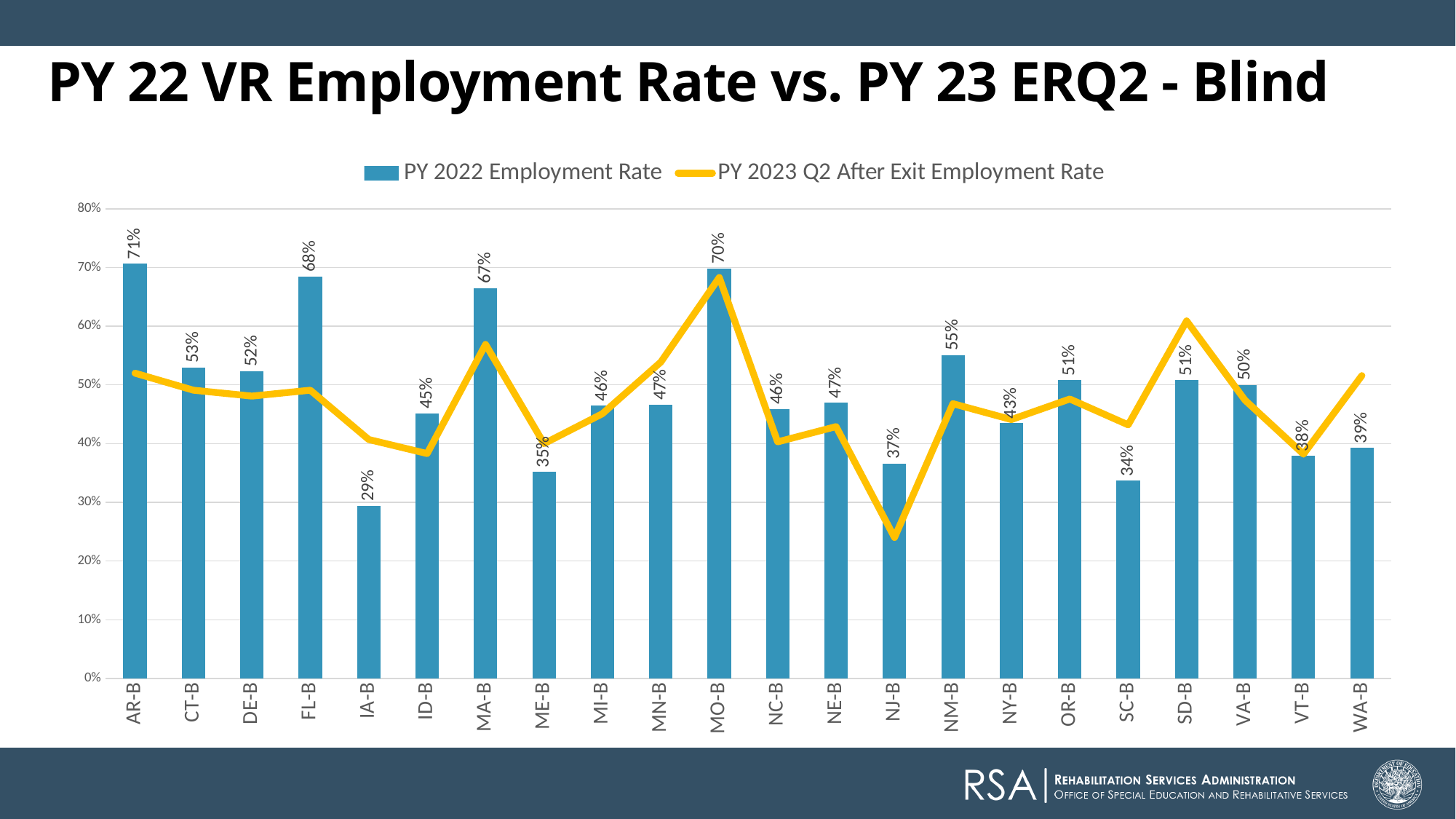
How many categories are shown on the x axis? 22 Is the PY 2023 Q2 After Exit Employment Rate for MO-B greater or less than 60%? greater Which has a higher PY 2022 Employment Rate, NM-B or NY-B? NM-B Which category has the lowest PY 2022 Employment Rate? IA-B Is the PY 2023 Q2 After Exit Employment Rate for NJ-B greater or less than 30%? less How many series does the legend list? 2 What is the PY 2022 Employment Rate for IA-B? 29% What is the difference between the PY 2022 Employment Rate for FL-B and ME-B? 33 percentage points What kind of chart is shown on the slide? A combination bar and line chart Which category has the highest PY 2022 Employment Rate? AR-B Which series is shown as a yellow line? PY 2023 Q2 After Exit Employment Rate What is the PY 2022 Employment Rate for AR-B? 71%